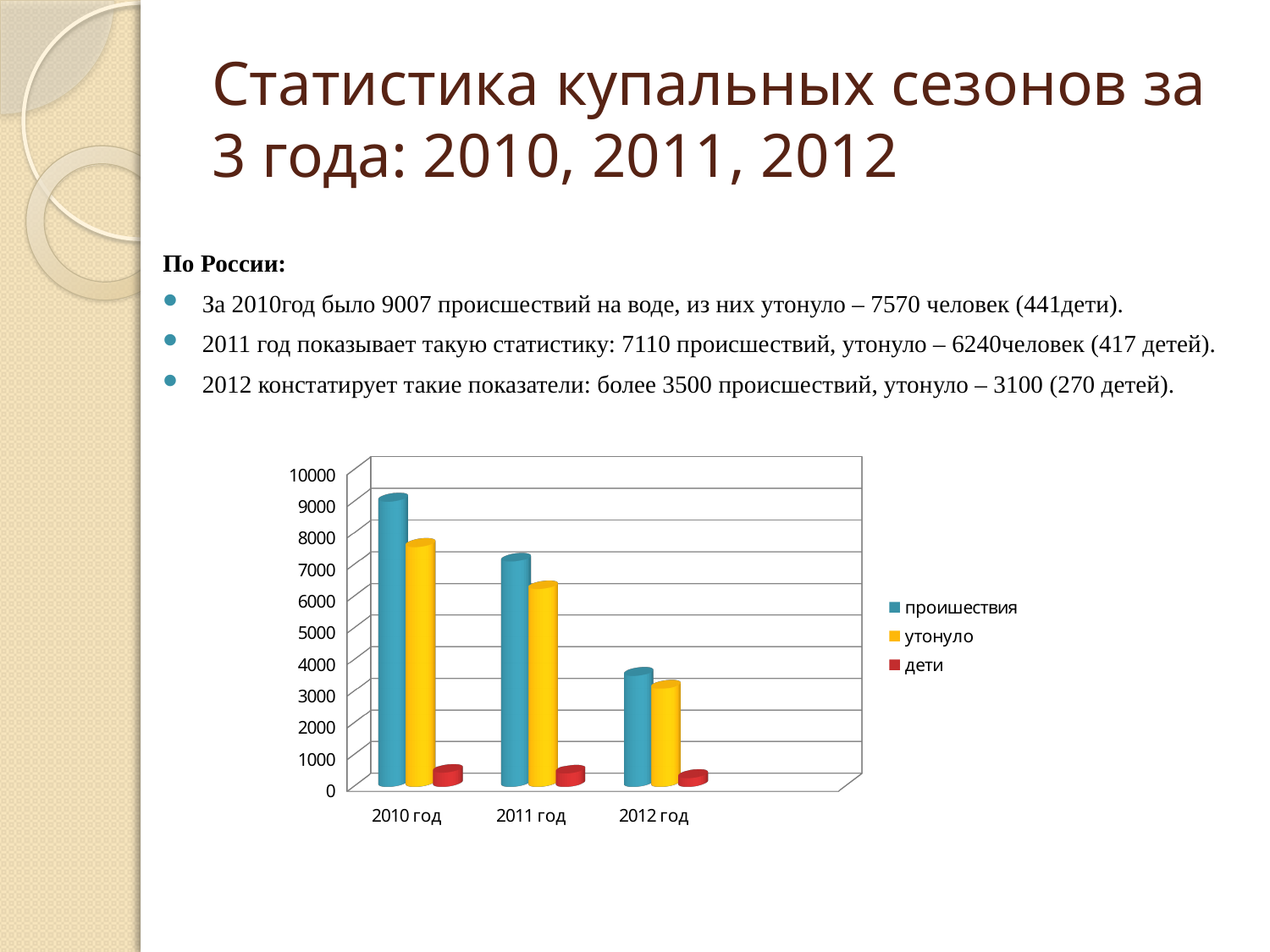
Is the value for проишествия in 2011 год greater or less than 8000? less How many series does the chart legend list? 3 How many year categories are shown on the x axis of the chart? 3 Which year has the lowest value for утонуло? 2012 год Is the value for проишествия in 2012 год greater or less than 4000? less Is the value for дети in 2011 год greater or less than 1000? less Do the values for утонуло rise or fall from 2010 год to 2012 год? fall Which year has the highest value for проишествия? 2010 год Which is larger: проишествия in 2010 год or проишествия in 2012 год? 2010 год What kind of chart is shown on the slide? bar chart